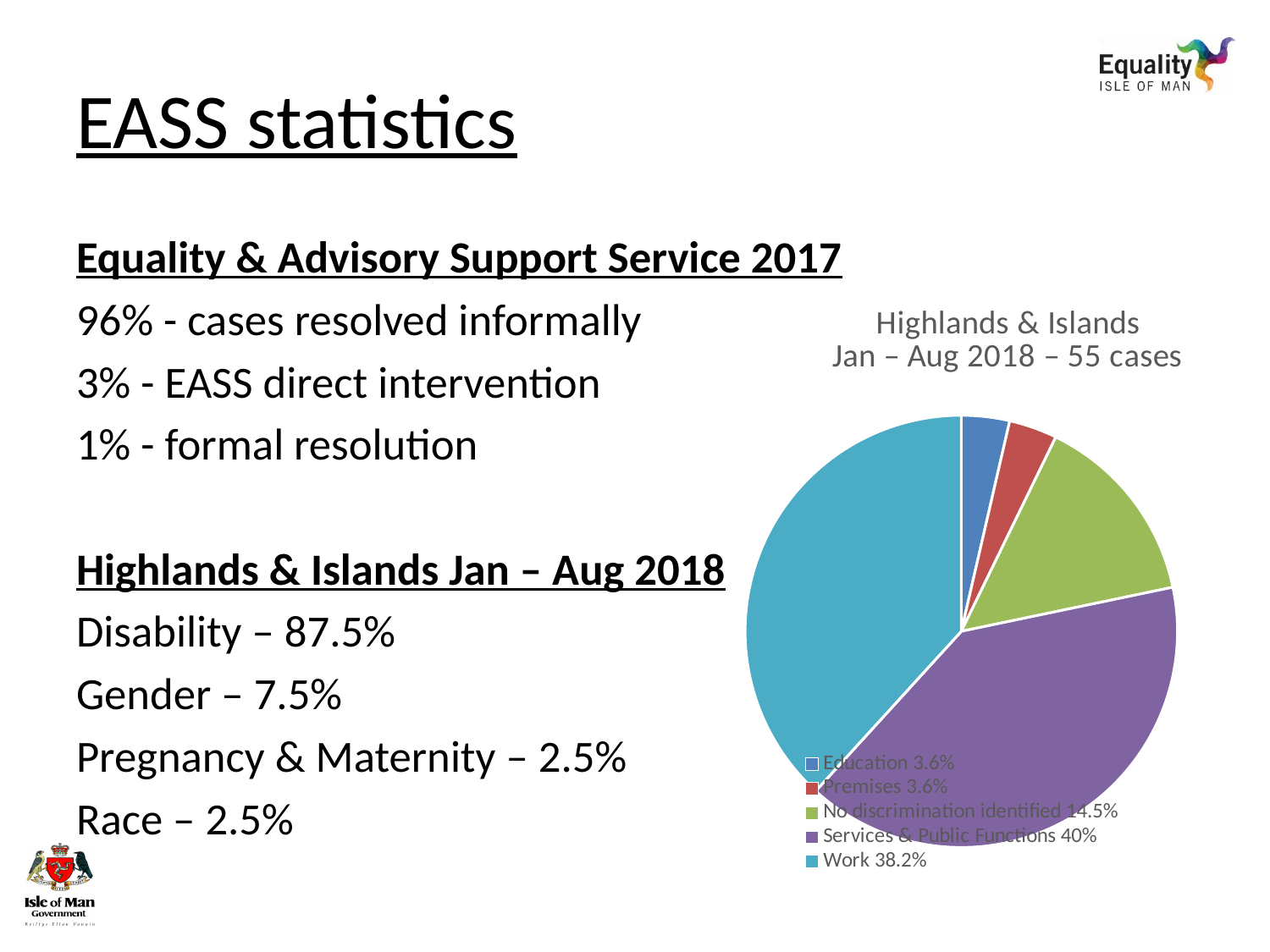
What share of the pie is Work? 38.2% What kind of chart is shown on the slide? Pie chart Which is larger, the share for Services & Public Functions or the share for Work? Services & Public Functions What share of the pie is No discrimination identified? 14.5% Which category has the largest share of the pie? Services & Public Functions What share of the pie is Premises? 3.6% What is the title of the pie chart? Highlands & Islands Jan – Aug 2018 – 55 cases How many cases does the pie chart title say the data covers? 55 cases What is the difference in percentage points between the Services & Public Functions share and the Work share? 1.8 How many categories does the pie chart show? 5